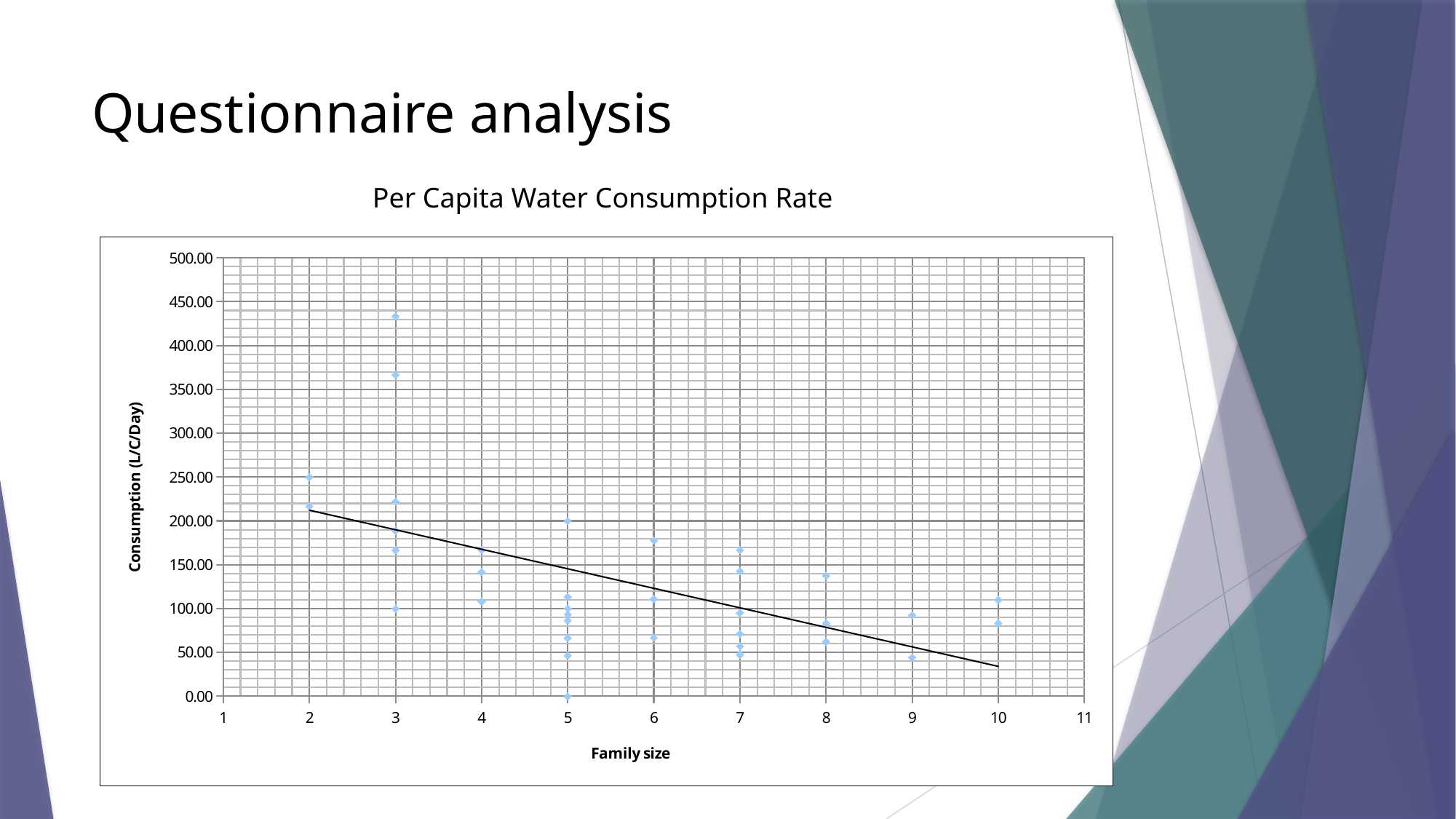
What is the label of the vertical axis? Consumption (L/C/Day) Is the lowest plotted value for family size 7 greater or less than 100? less Does the trend line rise or fall as family size increases? Fall What is the title of the chart? Per Capita Water Consumption Rate Are both plotted values for family size 9 greater or less than 100? less Is the highest plotted value for family size 3 greater or less than 400? greater What kind of chart is shown on the slide? Scatter chart How many distinct family sizes have data points plotted? 9 Which family size has the highest plotted consumption value? 3 Which has a higher maximum plotted value: family size 3 or family size 10? Family size 3